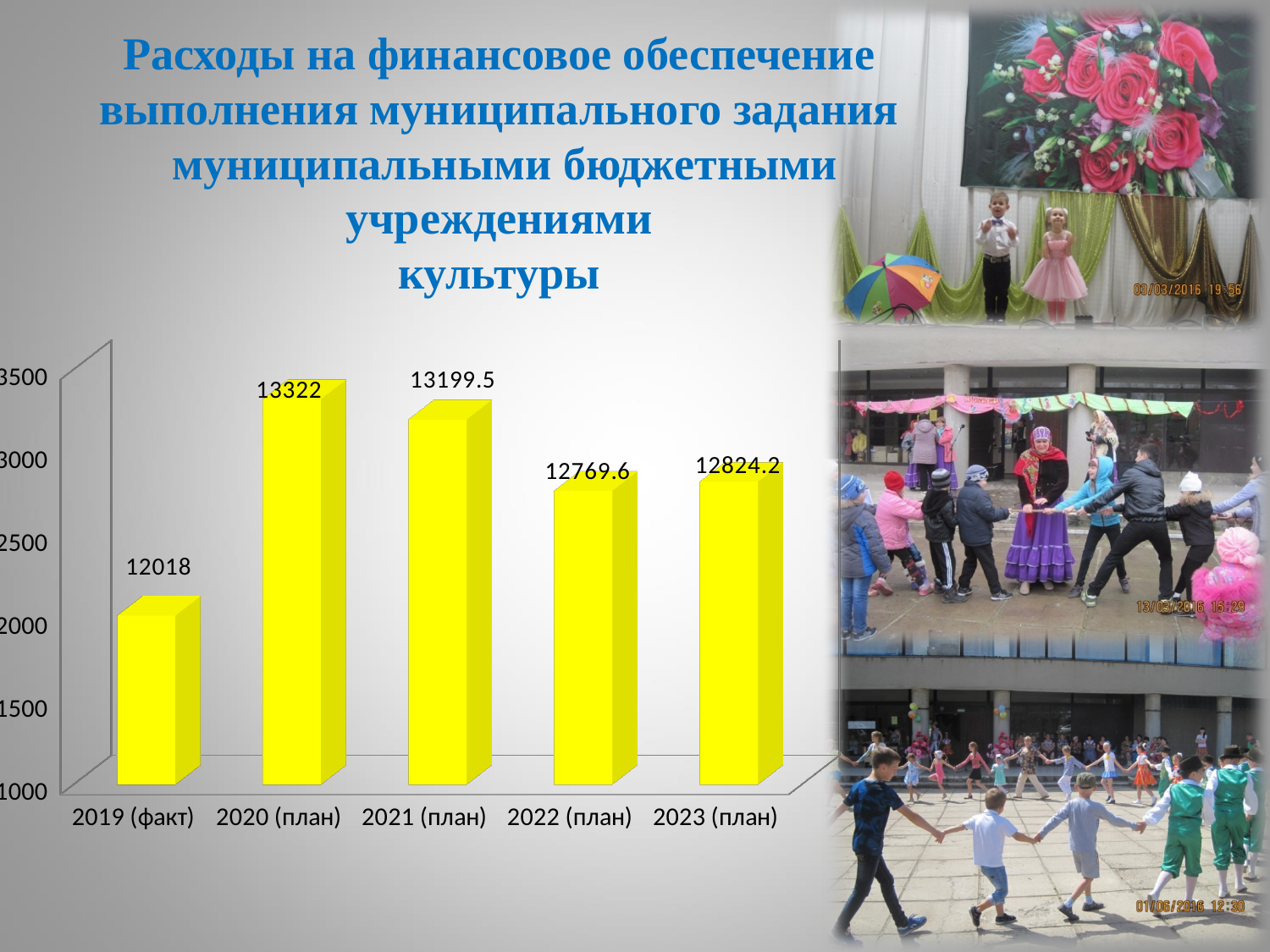
Which is larger, the value for 2020 (план) or 2021 (план)? 2020 (план) What is the value for 2019 (факт)? 12018 What is the difference between the values for 2020 (план) and 2019 (факт)? 1304 Which category has the highest value? 2020 (план) Which is larger, the value for 2022 (план) or 2023 (план)? 2023 (план) What colour are the bars in the chart? yellow What kind of chart is shown on the slide? bar chart What is the difference between the values for 2021 (план) and 2022 (план)? 429.9 What is the value for 2021 (план)? 13199.5 Which category has the lowest value? 2019 (факт) What is the value for 2023 (план)? 12824.2 How many categories are shown on the x axis? 5